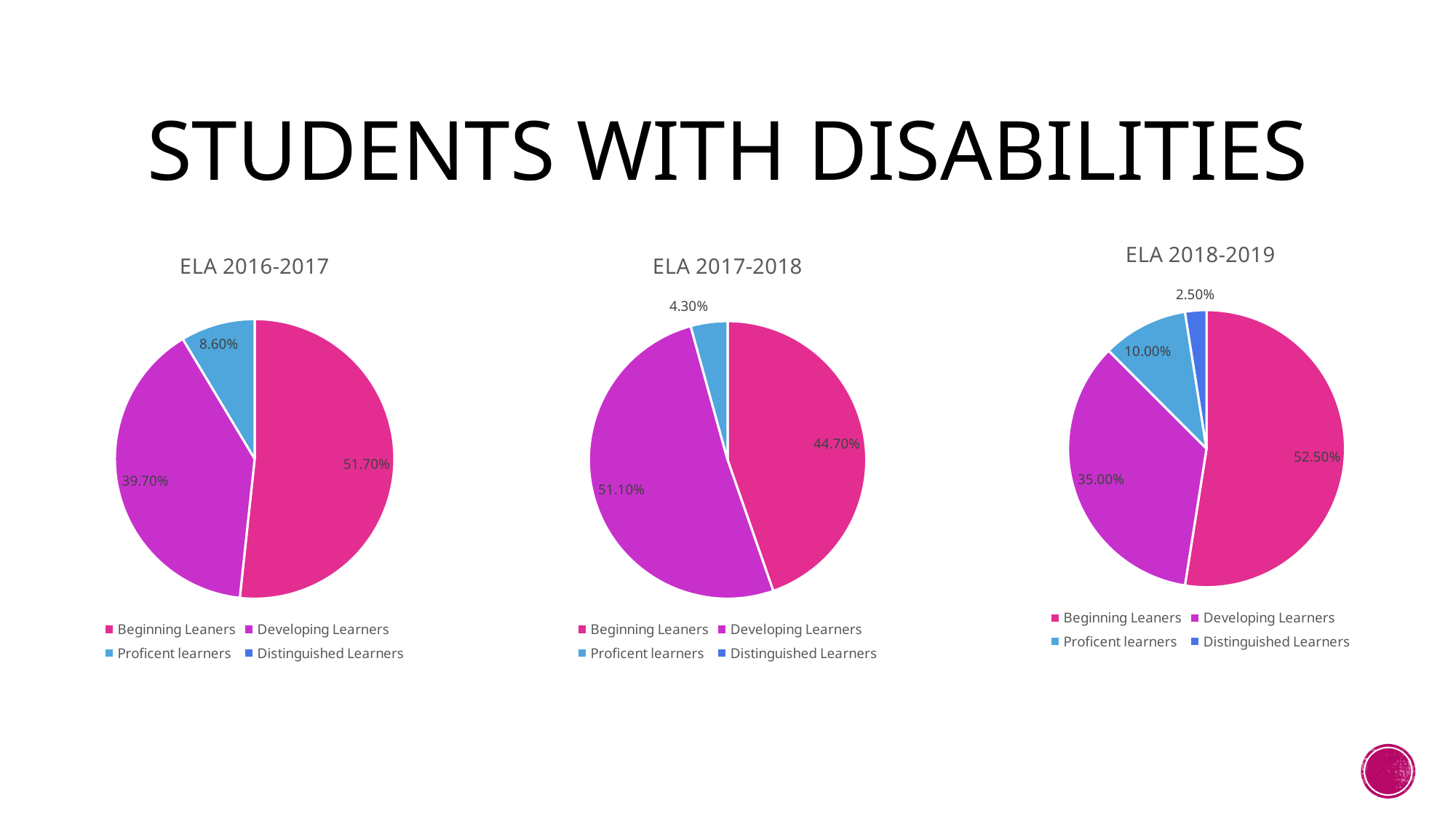
In the ELA 2018-2019 chart, what share is labelled for Distinguished Learners? 2.50% In the ELA 2017-2018 chart, what share is labelled for Proficent learners? 4.30% What type of chart is the ELA 2016-2017 chart? Pie chart In the ELA 2018-2019 chart, which category has the smallest slice? Distinguished Learners In the ELA 2017-2018 chart, what share is labelled for Developing Learners? 51.10% In the ELA 2017-2018 chart, which category has the largest slice? Developing Learners In the ELA 2018-2019 chart, which is larger, the Developing Learners slice or the Proficent learners slice? Developing Learners How many entries does the legend of the ELA 2017-2018 chart list? 4 In the ELA 2018-2019 chart, which category has the largest slice? Beginning Leaners In the ELA 2016-2017 chart, what share is labelled for Proficent learners? 8.60% In the ELA 2016-2017 chart, what is the difference between the Beginning Leaners and Developing Learners shares? 12.00% In the ELA 2016-2017 chart, what share is labelled for Beginning Leaners? 51.70%